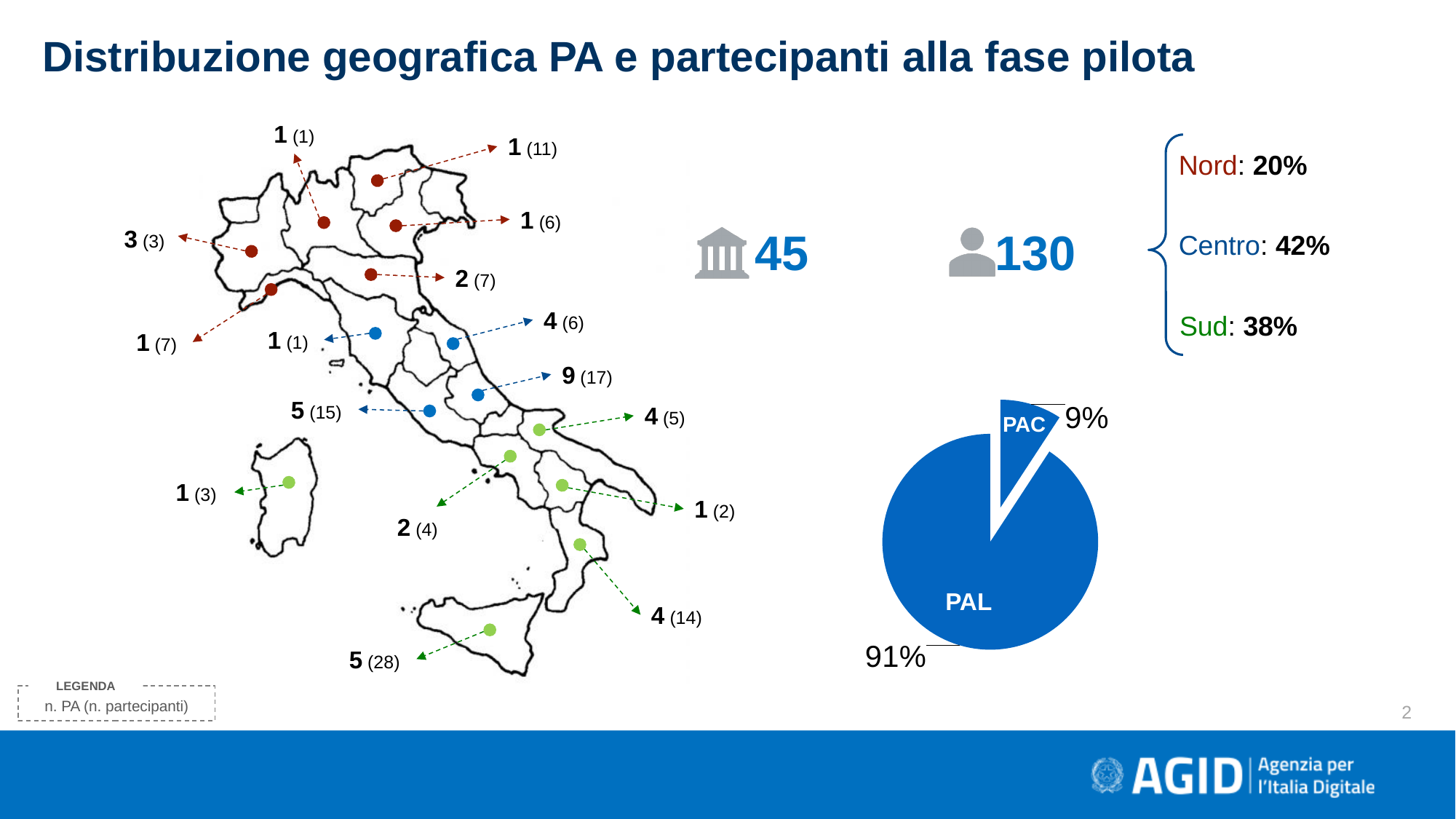
What is the difference in percentage points between the PAL and PAC slices of the pie chart? 82 In the pie chart, what share does PAL have? 91% In the pie chart, what share does PAC have? 9% Which slice of the pie chart is the largest? PAL Which slice of the pie chart is the smallest? PAC Which slice of the pie chart is pulled out (exploded) from the rest? PAC How many slices does the pie chart have? 2 What is the title of the slide containing the pie chart? Distribuzione geografica PA e partecipanti alla fase pilota What kind of chart is shown on the right side of the slide? pie chart In the pie chart, which is larger, PAL or PAC? PAL